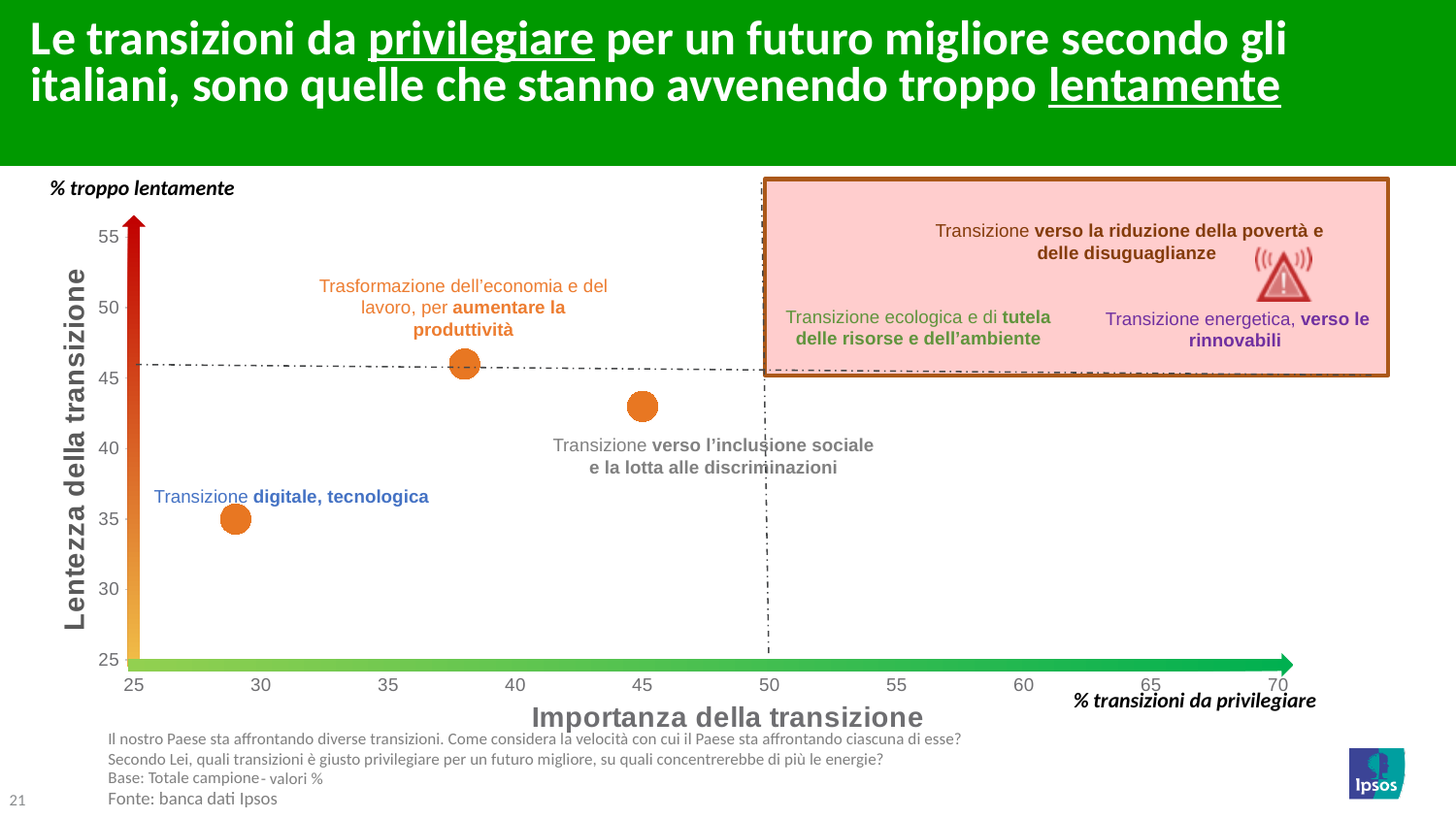
Is the horizontal-axis value for 'Trasformazione dell'economia e del lavoro, per aumentare la produttività' greater or less than 40? less Is the horizontal-axis value (Importanza della transizione) for 'Transizione digitale, tecnologica' greater or less than 35? less Is the vertical-axis value (Lentezza della transizione) for 'Transizione digitale, tecnologica' greater or less than 40? less What kind of chart is shown on the slide? scatter chart What is the title of the horizontal axis of the chart? Importanza della transizione Which has the higher vertical-axis value (Lentezza della transizione): 'Transizione digitale, tecnologica' or 'Transizione verso l'inclusione sociale e la lotta alle discriminazioni'? Transizione verso l'inclusione sociale e la lotta alle discriminazioni Among the visible plotted points, which transition has the lowest value on both axes? Transizione digitale, tecnologica What is the title of the vertical axis of the chart? Lentezza della transizione Which has the higher horizontal-axis value (Importanza della transizione): 'Transizione digitale, tecnologica' or 'Trasformazione dell'economia e del lavoro, per aumentare la produttività'? Trasformazione dell'economia e del lavoro, per aumentare la produttività